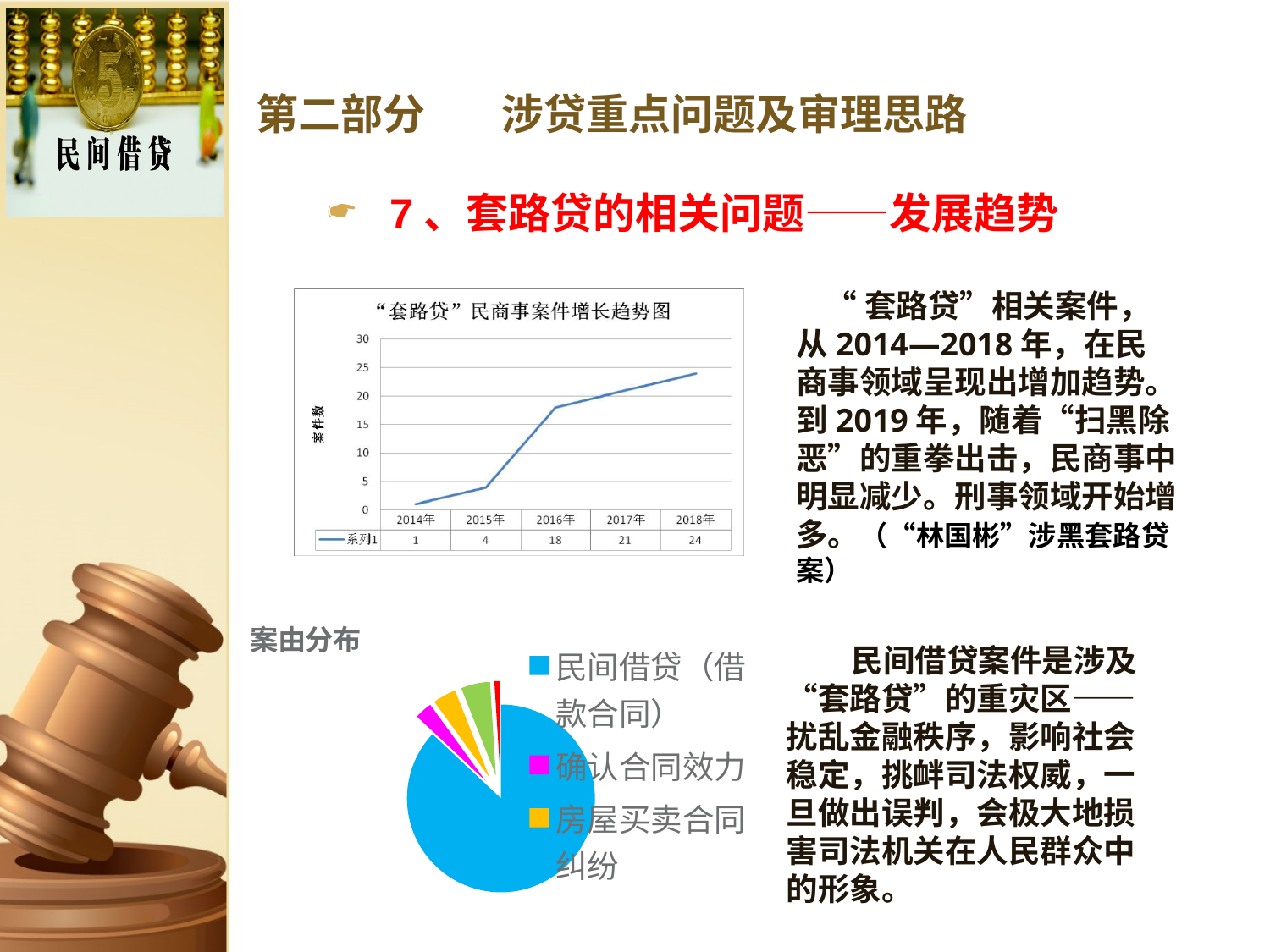
In the line chart titled “套路贷”民商事案件增长趋势图, how many years are plotted? 5 In the line chart titled “套路贷”民商事案件增长趋势图, what is the value for 2016年? 18 In the line chart titled “套路贷”民商事案件增长趋势图, do the values rise or fall from 2014年 to 2018年? rise In the line chart titled “套路贷”民商事案件增长趋势图, what is the value for 2018年? 24 In the line chart titled “套路贷”民商事案件增长趋势图, what is the value for 2014年? 1 What kind of chart is the one labelled 案由分布 at the bottom of the slide? pie chart In the line chart titled “套路贷”民商事案件增长趋势图, which year has the lowest value? 2014年 In the line chart titled “套路贷”民商事案件增长趋势图, which is larger, the value for 2017年 or the value for 2015年? 2017年 In the pie chart labelled 案由分布, which legend entry corresponds to the largest slice? 民间借贷（借款合同） In the line chart titled “套路贷”民商事案件增长趋势图, which year has the highest value? 2018年 What kind of chart is the one titled “套路贷”民商事案件增长趋势图? line chart In the line chart titled “套路贷”民商事案件增长趋势图, what is the difference between the values for 2016年 and 2015年? 14